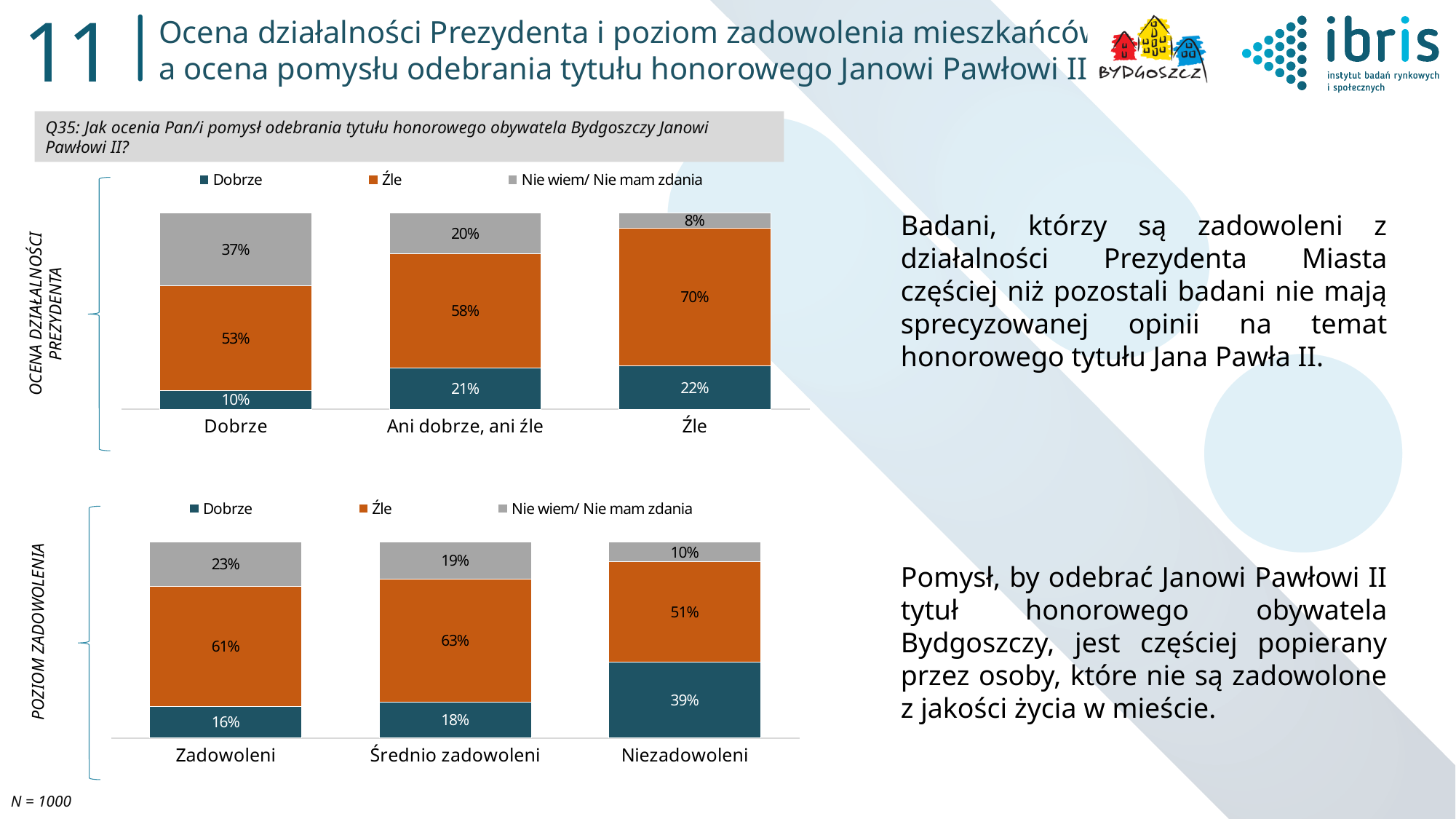
In the top chart (OCENA DZIAŁALNOŚCI PREZYDENTA), what is the difference between the 'Nie wiem/ Nie mam zdania' shares for 'Dobrze' and 'Źle'? 29 percentage points What type of chart is the bottom chart (POZIOM ZADOWOLENIA)? Stacked bar chart In the top chart (OCENA DZIAŁALNOŚCI PREZYDENTA), what is the 'Źle' value for the 'Ani dobrze, ani źle' category? 58% In the top chart (OCENA DZIAŁALNOŚCI PREZYDENTA), which category has the highest 'Źle' share? Źle In the bottom chart (POZIOM ZADOWOLENIA), what is the total of the stacked bar for 'Zadowoleni'? 100% In the top chart (OCENA DZIAŁALNOŚCI PREZYDENTA), which category has the lowest 'Dobrze' share? Dobrze In the bottom chart (POZIOM ZADOWOLENIA), what is the 'Dobrze' value for 'Niezadowoleni'? 39% How many series does the legend of the top chart (OCENA DZIAŁALNOŚCI PREZYDENTA) list? 3 In the bottom chart (POZIOM ZADOWOLENIA), which category has the lowest 'Źle' share? Niezadowoleni In the top chart (OCENA DZIAŁALNOŚCI PREZYDENTA), what share of respondents who rate the President 'Dobrze' answered 'Nie wiem/ Nie mam zdania'? 37% In the bottom chart (POZIOM ZADOWOLENIA), is the 'Źle' share larger for 'Zadowoleni' or for 'Niezadowoleni'? Zadowoleni In the bottom chart (POZIOM ZADOWOLENIA), what is the 'Nie wiem/ Nie mam zdania' value for 'Średnio zadowoleni'? 19%